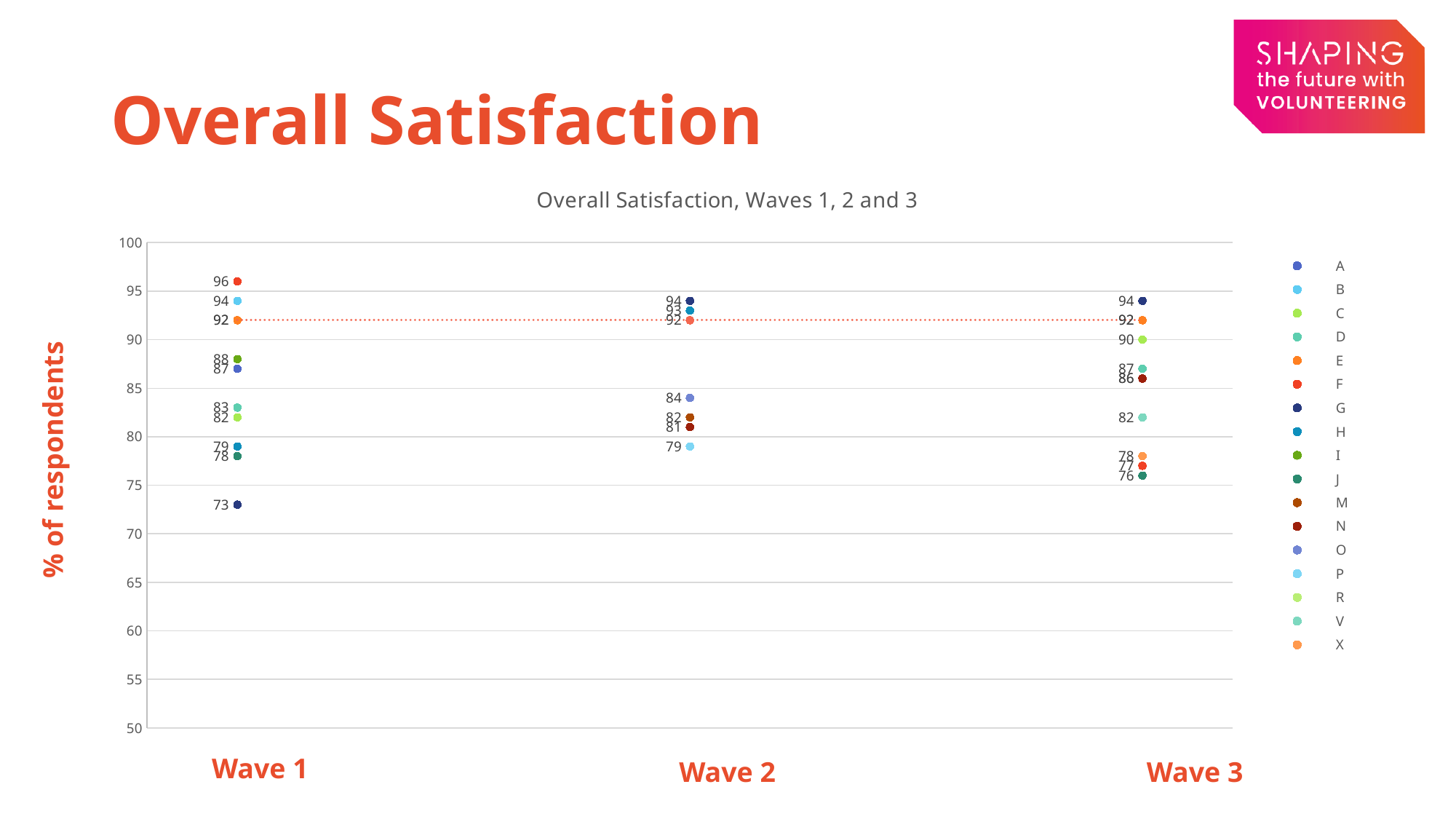
How many series does the legend list? 17 What is the lowest value plotted in Wave 1? 73 What is the highest value plotted in Wave 1? 96 What is the difference between the highest and lowest values in Wave 1? 23 What is the difference between the highest and lowest values in Wave 3? 18 What is the title of the chart? Overall Satisfaction, Waves 1, 2 and 3 What is the label on the y axis? % of respondents What is the lowest value plotted in Wave 2? 79 What is the lowest value plotted in Wave 3? 76 How many waves are shown along the x axis? 3 What is the highest value plotted in Wave 2? 94 What kind of chart is shown on the slide? Scatter (dot) chart